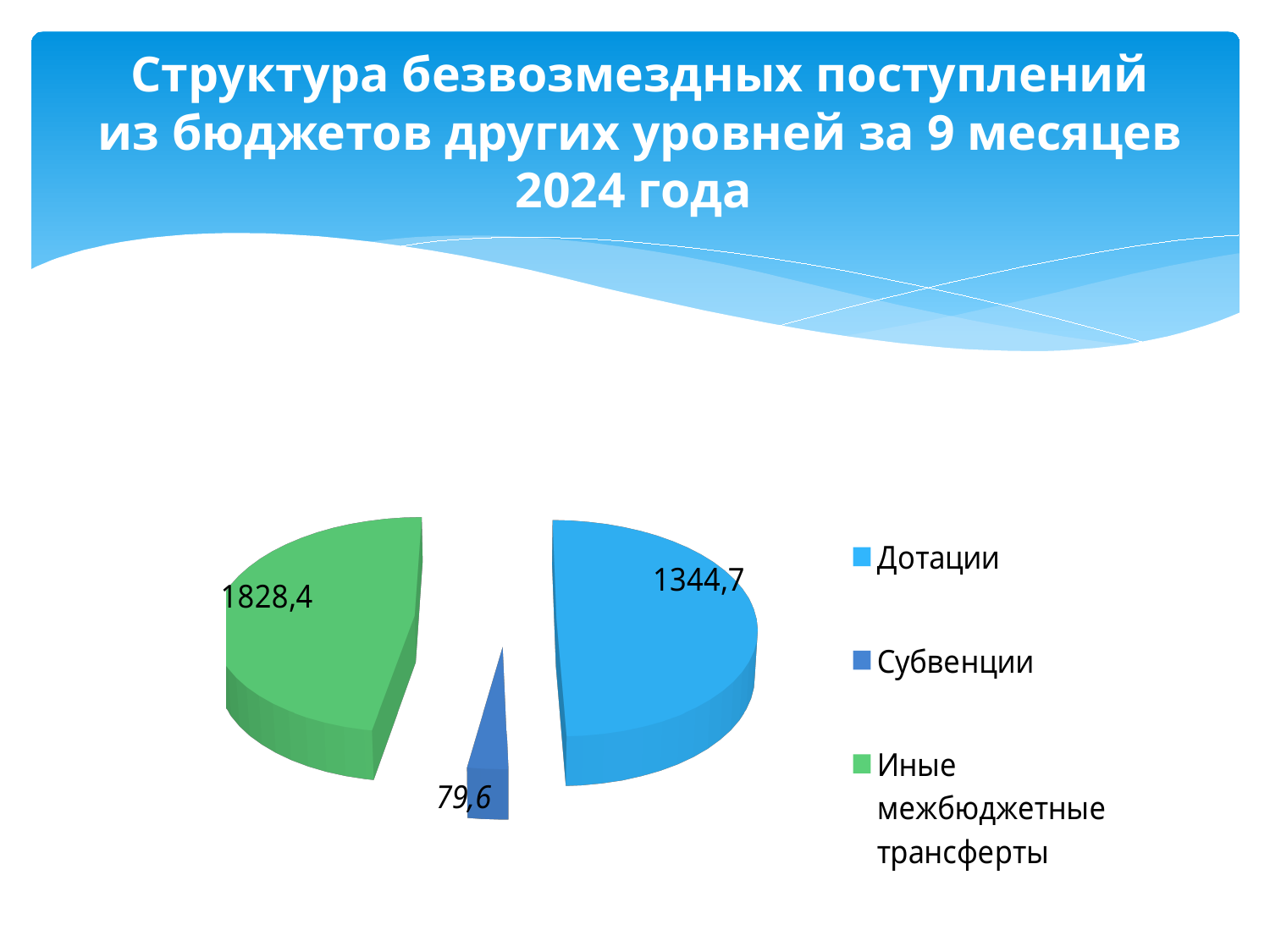
What is the difference between the values for Дотации and Субвенции? 1265,1 What is the value for Дотации? 1344,7 How many categories does the pie chart have? 3 What colour is the slice for Иные межбюджетные трансферты? Green What is the value for Субвенции? 79,6 What is the total of all three slices of the pie? 3252,7 Which category has the smallest slice of the pie? Субвенции Which is larger, the value for Дотации or the value for Иные межбюджетные трансферты? Иные межбюджетные трансферты What kind of chart is shown on the slide? Pie chart What is the value for Иные межбюджетные трансферты? 1828,4 What is the difference between the values for Иные межбюджетные трансферты and Дотации? 483,7